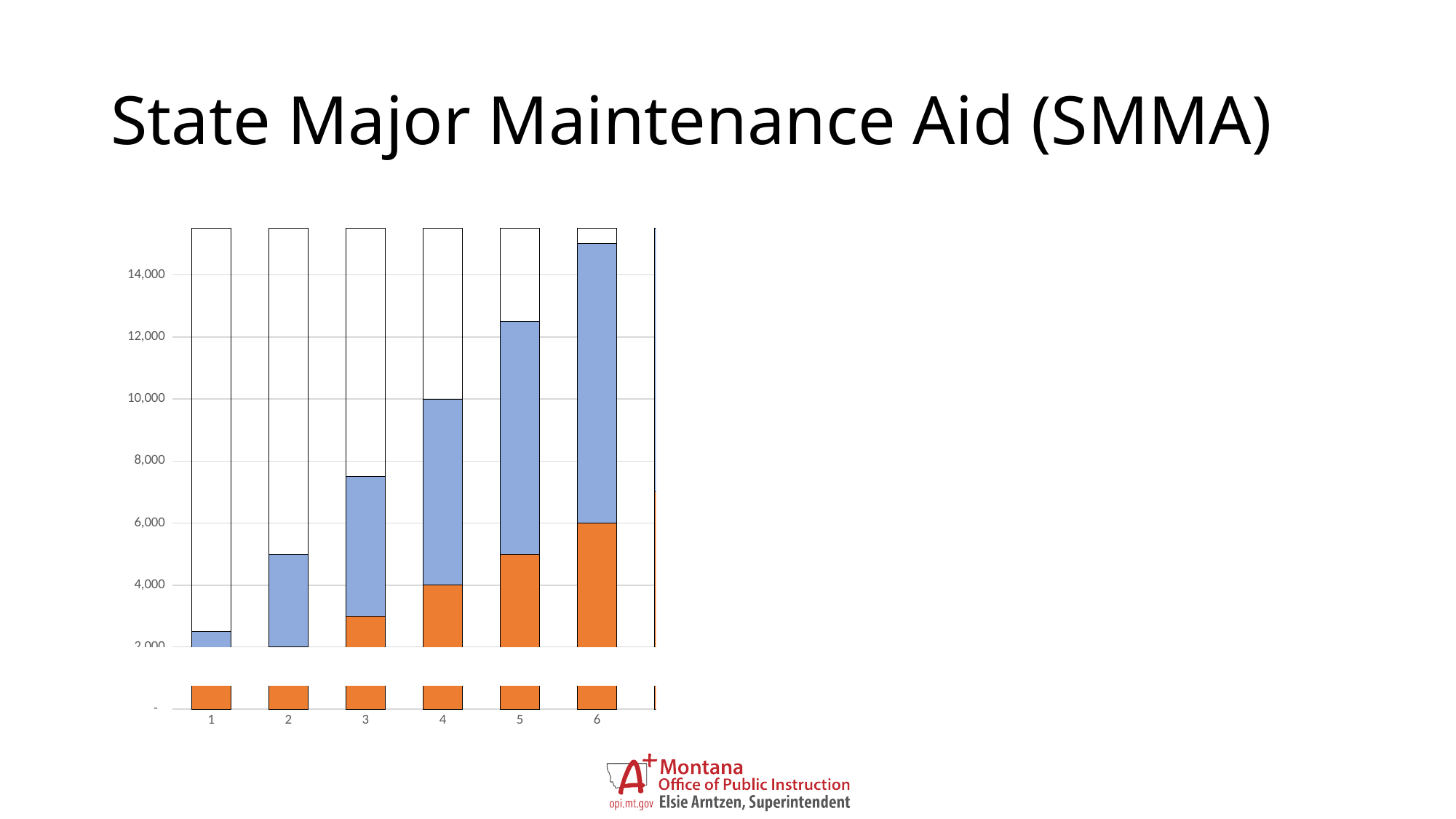
What is the title of the slide containing the chart? State Major Maintenance Aid (SMMA) Is the top of the blue segment for category 6 greater or less than 14,000? greater What colour is the bottom segment of each stacked bar? orange Which category has the highest top of the blue segment? 6 Is the top of the blue segment for category 3 greater or less than 8,000? less What kind of chart is shown on the slide? bar chart At what value does the top of the blue segment for category 4 land on the axis? 10,000 How many categories are shown on the x axis of the chart? 6 Which category has the lowest top of the blue segment? 1 Is the top of the blue segment for category 1 greater or less than 4,000? less Which category has a higher top of the blue segment, category 2 or category 4? 4 Do the tops of the blue segments rise or fall from category 1 to category 6? rise